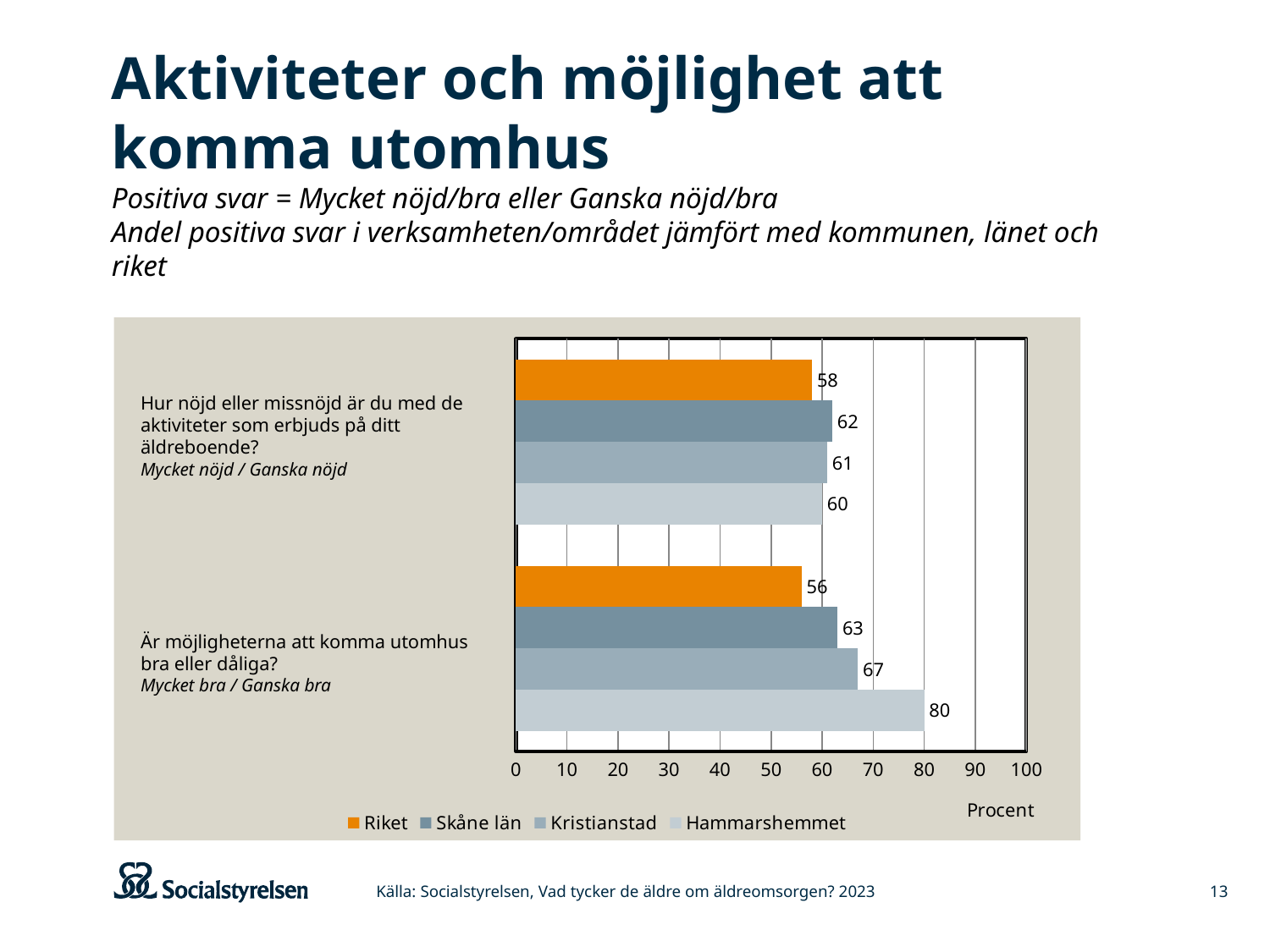
What is the value for Kristianstad on the question "Är möjligheterna att komma utomhus bra eller dåliga?"? 67 Which series has the highest value on the question "Är möjligheterna att komma utomhus bra eller dåliga?"? Hammarshemmet What is the value for Skåne län on the question "Hur nöjd eller missnöjd är du med de aktiviteter som erbjuds på ditt äldreboende?"? 62 What kind of chart is shown on the slide? Bar chart How many series does the legend list? 4 Which is larger on the question "Är möjligheterna att komma utomhus bra eller dåliga?": Kristianstad or Skåne län? Kristianstad What unit is shown on the x axis of the chart? Procent What is the difference between Hammarshemmet and Riket on the question "Är möjligheterna att komma utomhus bra eller dåliga?"? 24 What is the value for Hammarshemmet on the question "Är möjligheterna att komma utomhus bra eller dåliga?"? 80 Which series has the lowest value on the question "Hur nöjd eller missnöjd är du med de aktiviteter som erbjuds på ditt äldreboende?"? Riket What is the value for Riket on the question "Hur nöjd eller missnöjd är du med de aktiviteter som erbjuds på ditt äldreboende?"? 58 How many survey questions (categories) are shown in the chart? 2